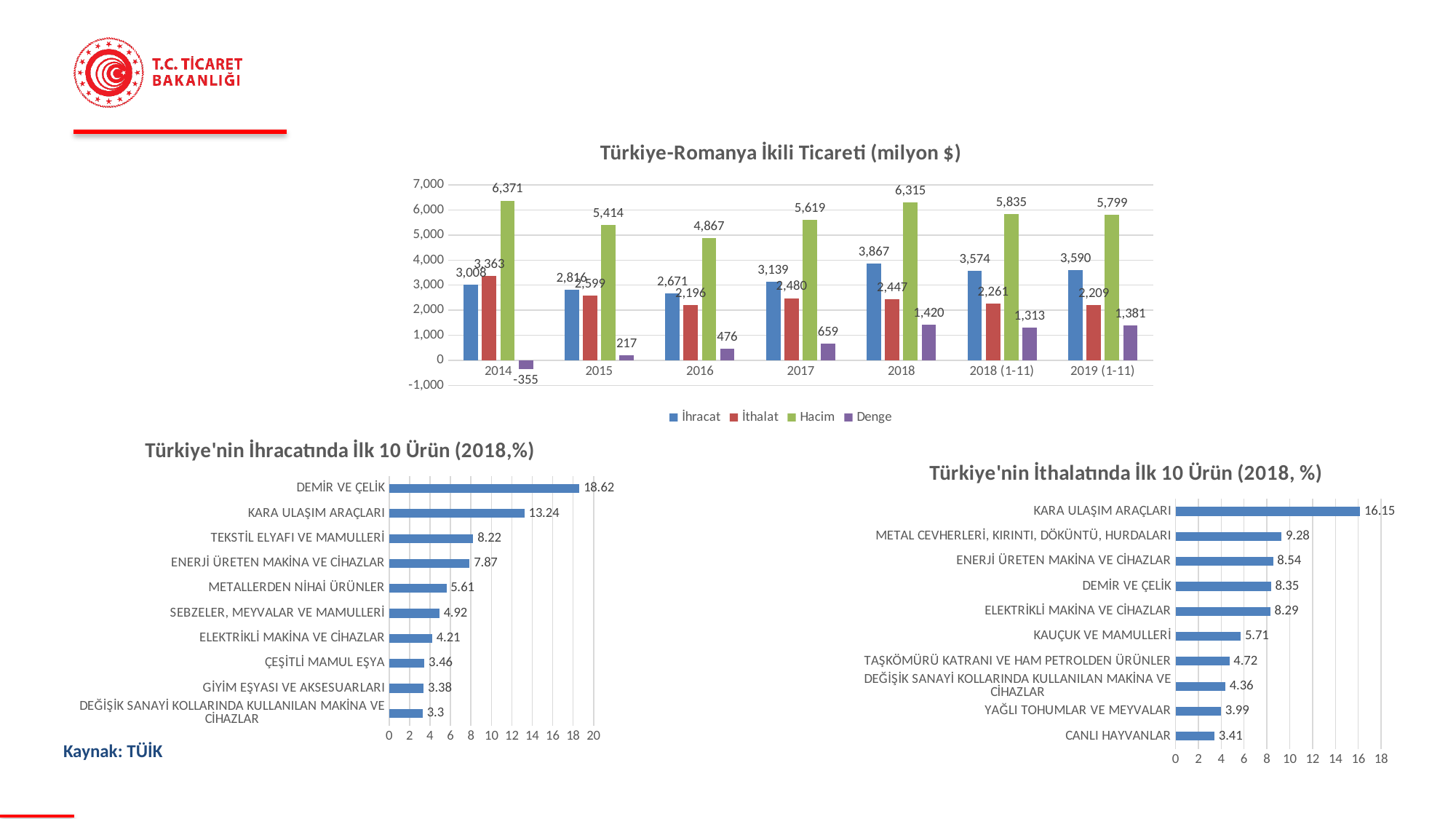
In the chart 'Türkiye-Romanya İkili Ticareti (milyon $)', which year has the highest Hacim value? 2014 In the chart 'Türkiye'nin İhracatında İlk 10 Ürün (2018,%)', what is the value for KARA ULAŞIM ARAÇLARI? 13.24 In the chart 'Türkiye'nin İthalatında İlk 10 Ürün (2018, %)', which product has the highest value? KARA ULAŞIM ARAÇLARI In the chart 'Türkiye-Romanya İkili Ticareti (milyon $)', what is the Denge value for 2014? -355 In the chart 'Türkiye-Romanya İkili Ticareti (milyon $)', what is the İhracat value for 2018? 3,867 In the chart 'Türkiye-Romanya İkili Ticareti (milyon $)', is the İthalat value for 2014 larger or smaller than the İhracat value for 2014? larger In the chart 'Türkiye-Romanya İkili Ticareti (milyon $)', how many series does the legend list? 4 In the chart 'Türkiye'nin İhracatında İlk 10 Ürün (2018,%)', which product has the lowest value? DEĞİŞİK SANAYİ KOLLARINDA KULLANILAN MAKİNA VE CİHAZLAR In the chart 'Türkiye-Romanya İkili Ticareti (milyon $)', how many year categories are shown on the x axis? 7 What kind of chart is 'Türkiye'nin İhracatında İlk 10 Ürün (2018,%)'? Bar chart In the chart 'Türkiye'nin İthalatında İlk 10 Ürün (2018, %)', what is the value for KAUÇUK VE MAMULLERİ? 5.71 In the chart 'Türkiye-Romanya İkili Ticareti (milyon $)', what is the difference between İhracat and İthalat in 2017? 659